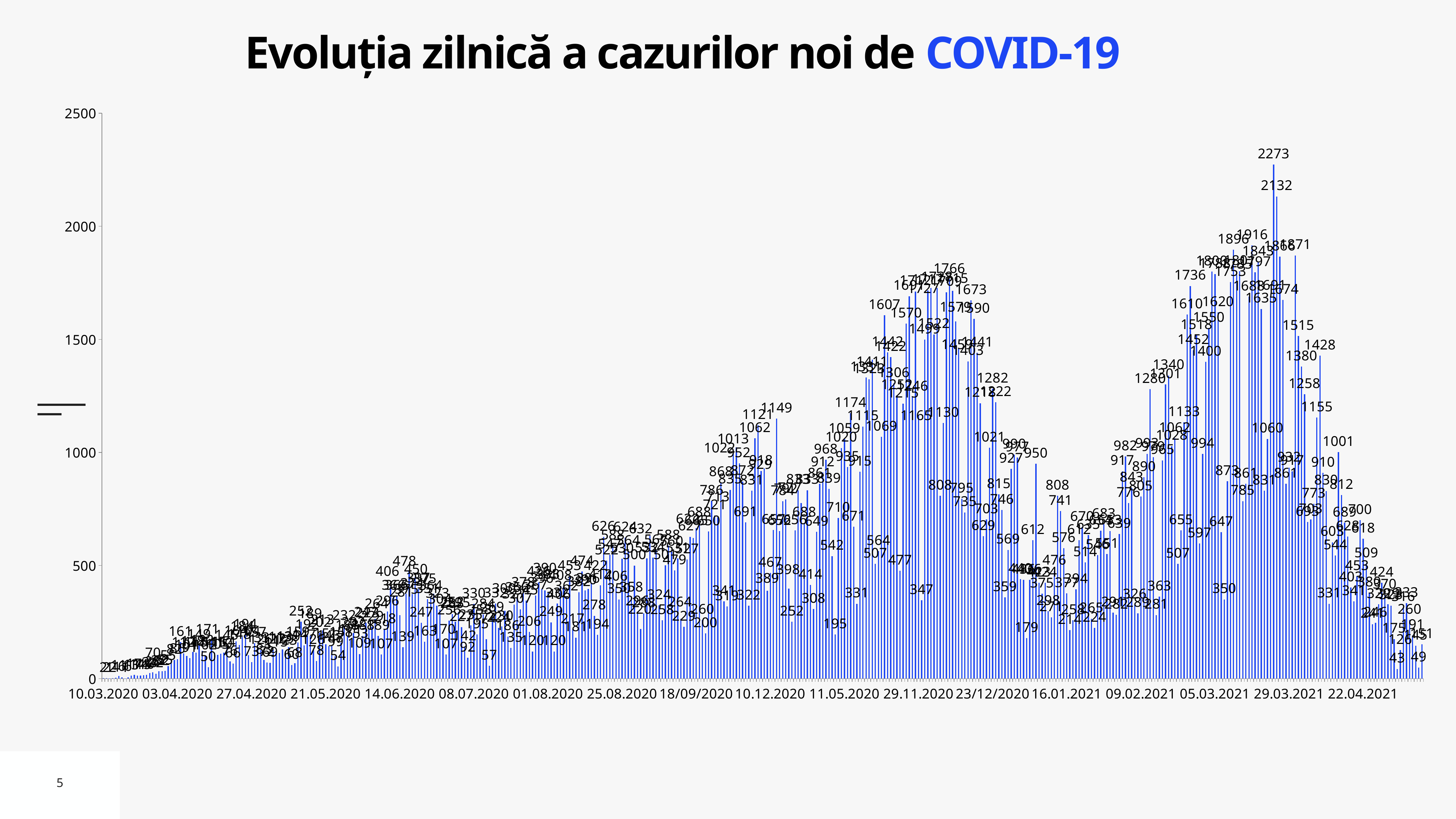
What is the first date label on the horizontal axis? 10.03.2020 Is the highest value on the chart greater or less than 2000? greater Which is larger: the late-2020 peak labelled 1766 or the 2021 peak labelled 2273? 2273 What is the last date label on the horizontal axis? 22.04.2021 What is the difference between the two highest labelled values, 2273 and 2132? 141 What is the title of the chart? Evoluția zilnică a cazurilor noi de COVID-19 What is the highest daily value labelled on the chart? 2273 What kind of chart is shown on the slide? bar chart Is the peak labelled 1766 greater or less than 1500? greater What is the highest tick value shown on the vertical axis? 2500 What is the second-highest value labelled on the chart, just below the 2273 peak? 2132 Do the values rise or fall between 10.03.2020 and 03.04.2020? rise